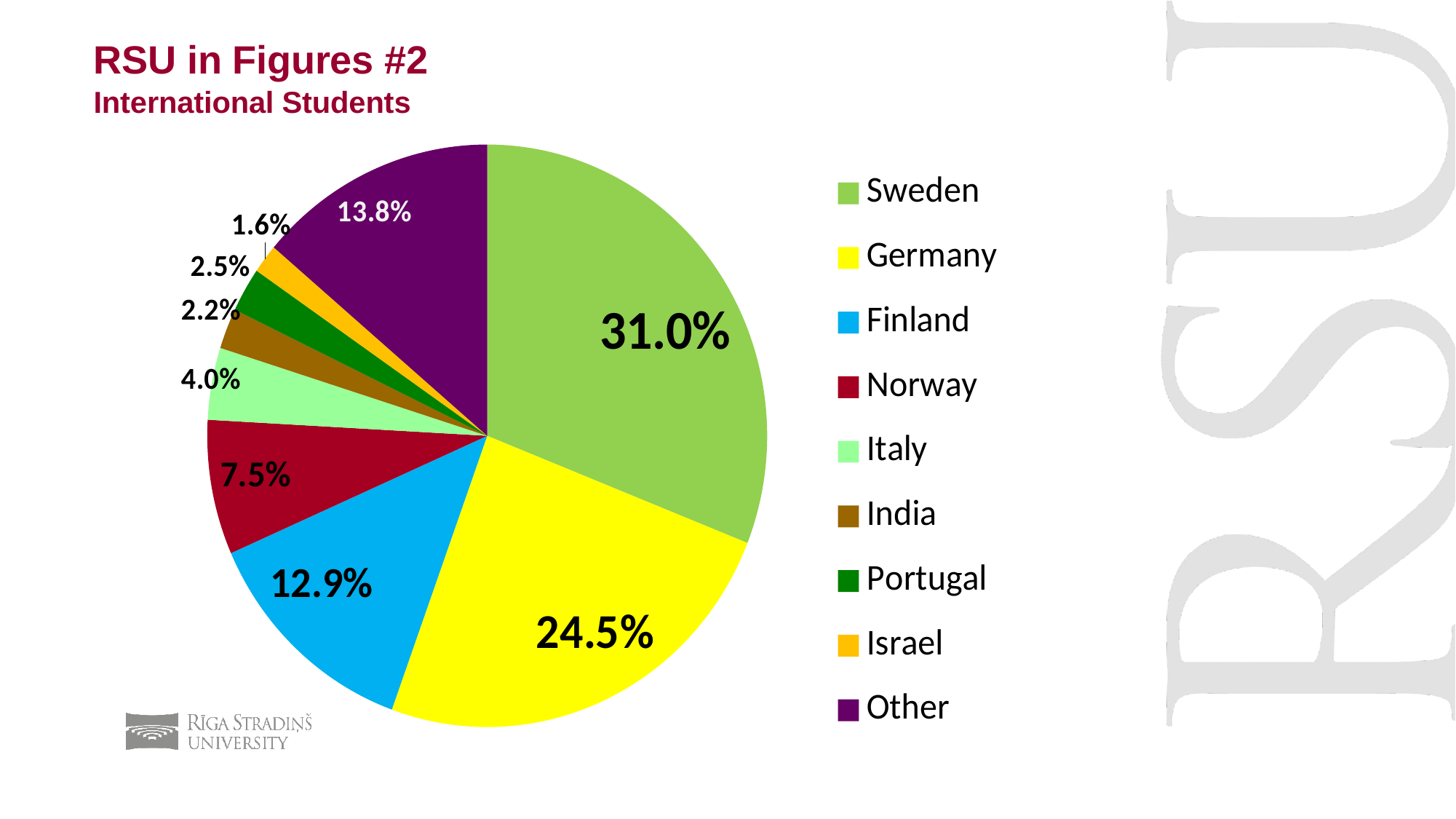
What is the difference between the shares of Sweden and Germany? 6.5% What kind of chart is shown on the slide? Pie chart What is the value shown for Finland? 12.9% What percentage is shown for Norway? 7.5% How many categories does the legend list? 9 What percentage of the pie is Germany? 24.5% Which country has the largest share of international students? Sweden What share does the Other slice represent? 13.8% What share of international students comes from Sweden? 31.0% Which category has the smallest slice of the pie? Israel Which is larger, the share for Finland or the share for Other? Other What colour is the slice for Portugal? Dark green